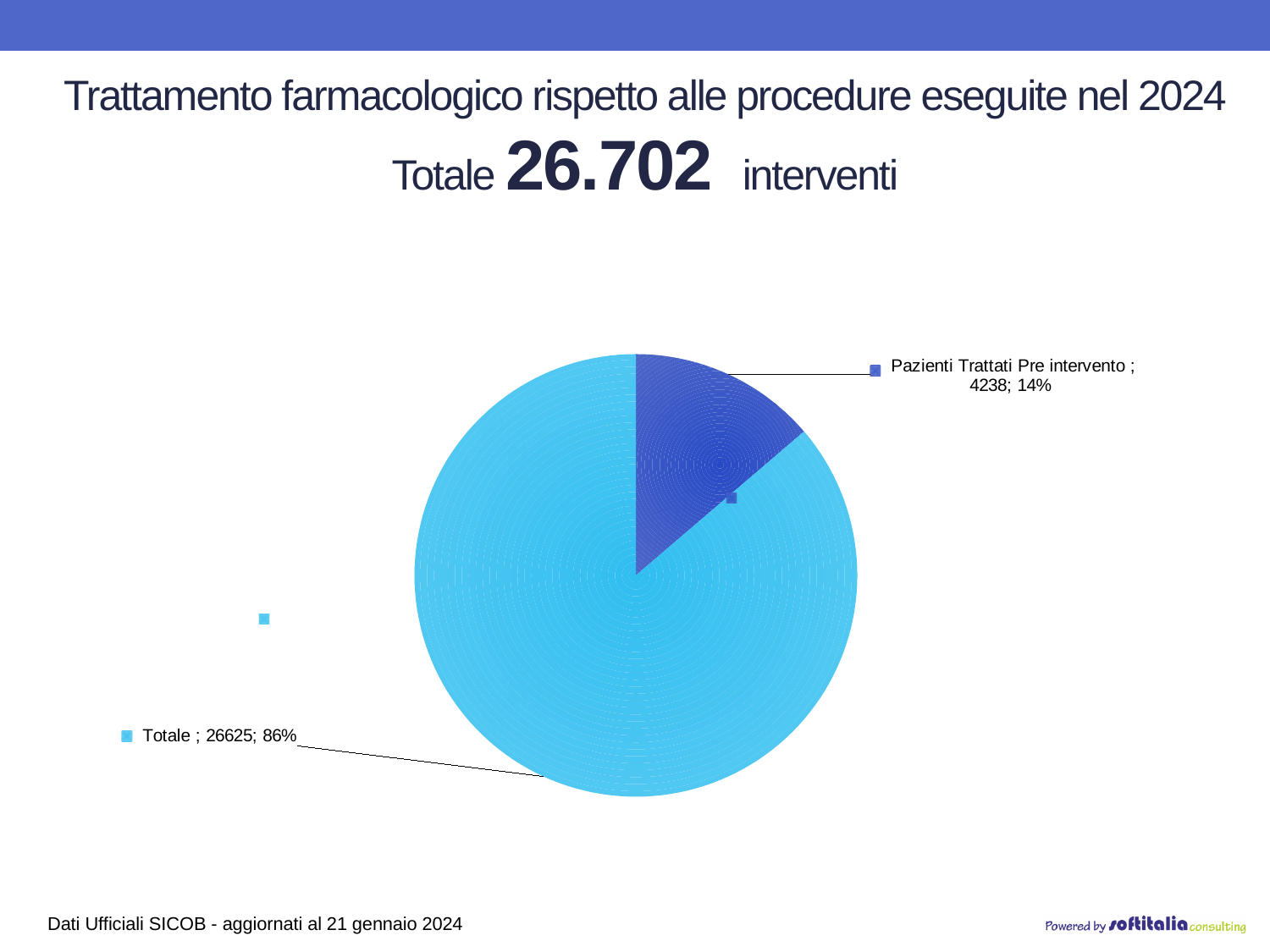
What colour is the slice for "Pazienti Trattati Pre intervento"? dark blue Which slice of the pie chart is the largest? Totale What percentage share of the pie does "Totale" represent? 86% What percentage share of the pie does "Pazienti Trattati Pre intervento" represent? 14% What is the difference between the value for "Totale" and the value for "Pazienti Trattati Pre intervento"? 22387 What is the value shown for the slice "Pazienti Trattati Pre intervento"? 4238 How many slices does the pie chart have? 2 What total number of interventions is stated in the slide heading? 26.702 What kind of chart is shown on the slide? pie chart Which slice of the pie chart is the smallest? Pazienti Trattati Pre intervento Which is larger, the value for "Totale" or the value for "Pazienti Trattati Pre intervento"? Totale What is the value shown for the slice "Totale"? 26625